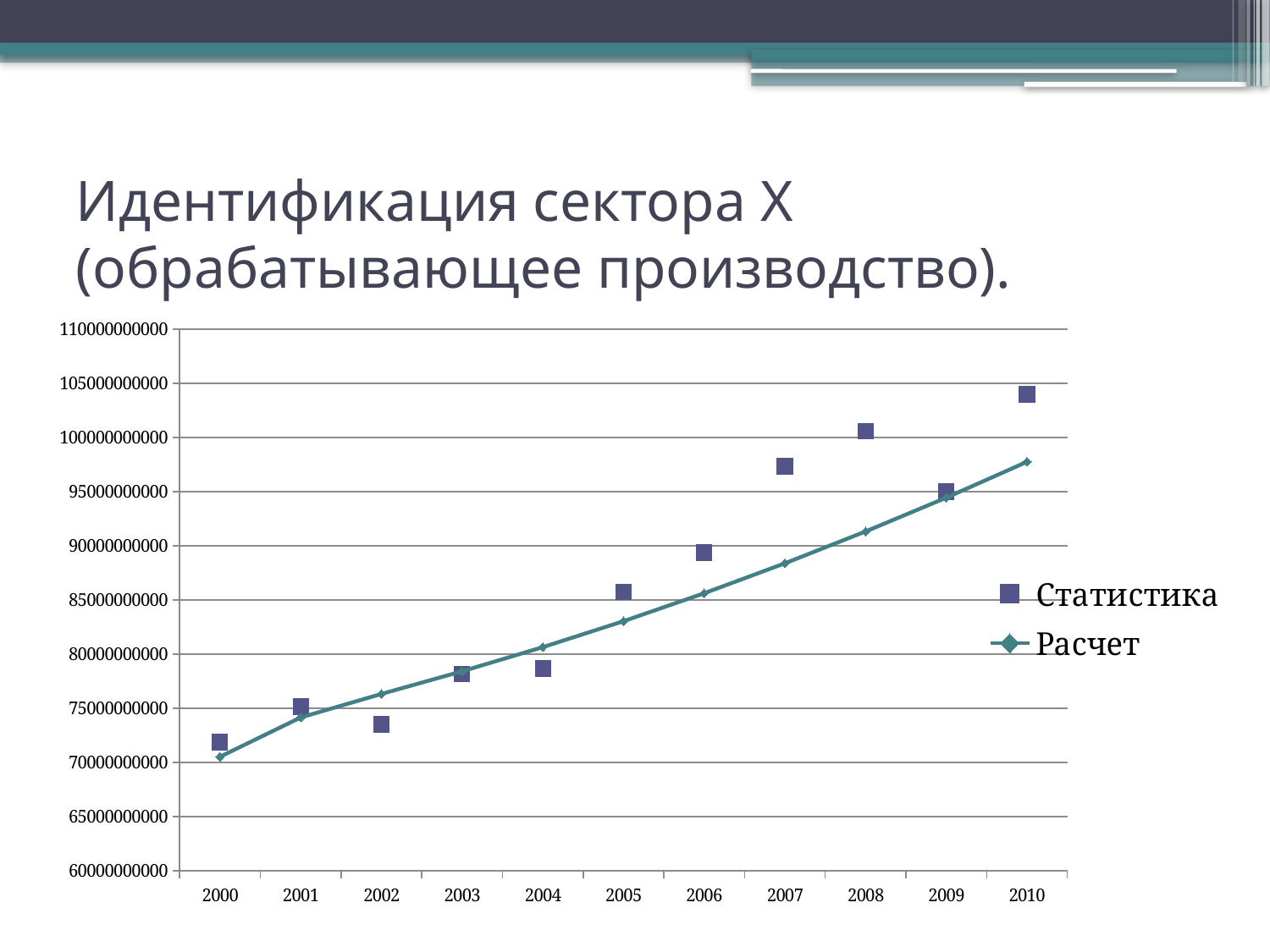
Is the Статистика value for 2010 greater or less than 100000000000? greater Does the Расчет series rise or fall from 2000 to 2010? rise In 2004, which series has the larger value, Статистика or Расчет? Расчет In 2010, which series has the larger value, Статистика or Расчет? Статистика What are the names of the two series in the legend? Статистика and Расчет Is the Расчет value for 2005 greater or less than 85000000000? less Is the Расчет value for 2010 greater or less than 100000000000? less How many series does the legend list? 2 In which year is the Статистика value highest? 2010 How many years are shown on the x axis? 11